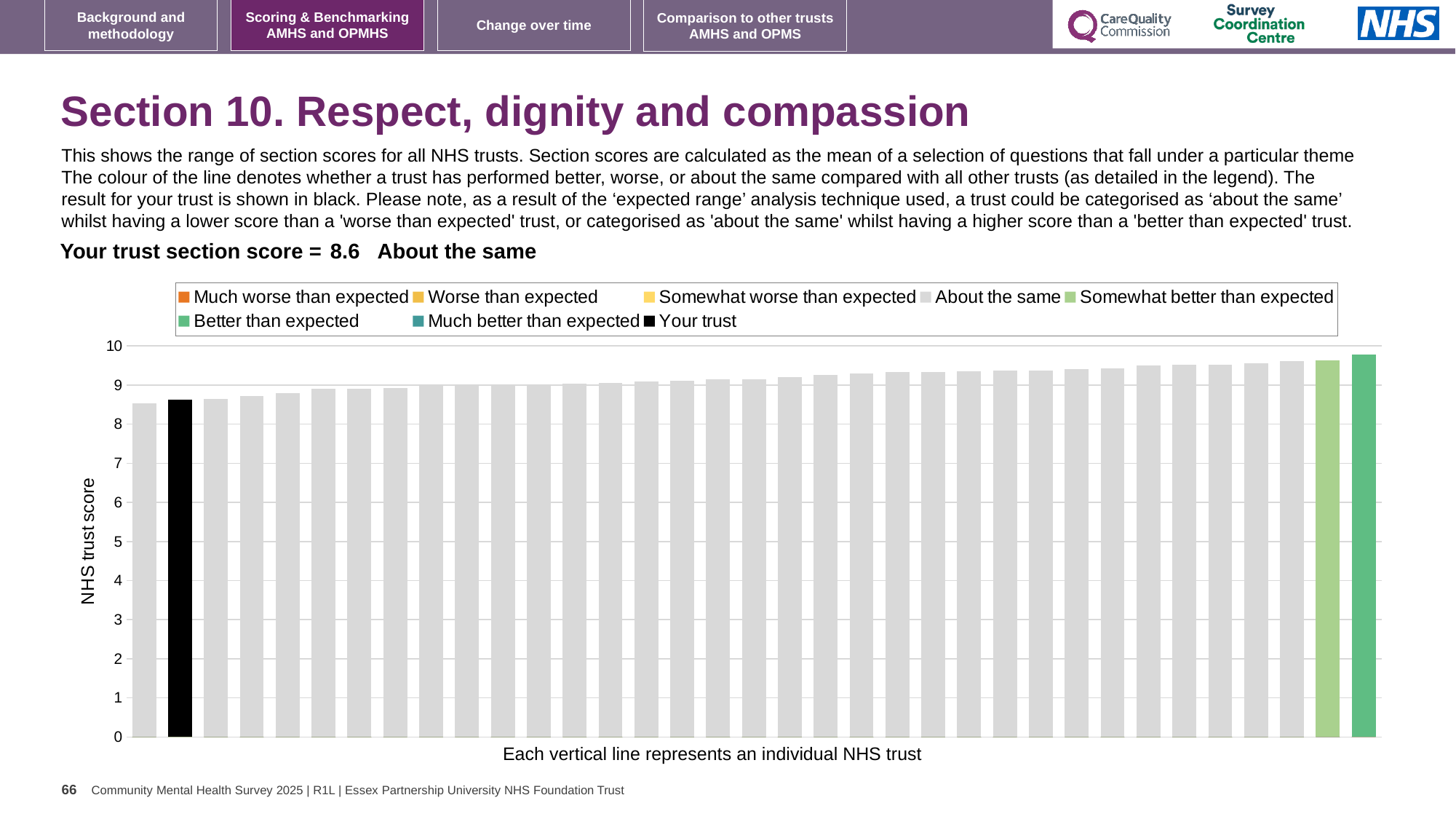
Is the value of the shortest bar (leftmost) greater or less than 9? less What kind of chart is shown on the slide? bar chart How many entries does the chart legend list? 8 What is the section score for your trust shown on the slide? 8.6 How many bars in the chart are coloured green rather than grey or black? 2 What is the label on the vertical axis of the chart? NHS trust score Is the value of the black 'Your trust' bar greater or less than 9? less Do the bar values rise or fall from left to right across the chart? rise Is the value of the black 'Your trust' bar greater or less than 8? greater Which category is your trust placed in according to the text above the chart? About the same